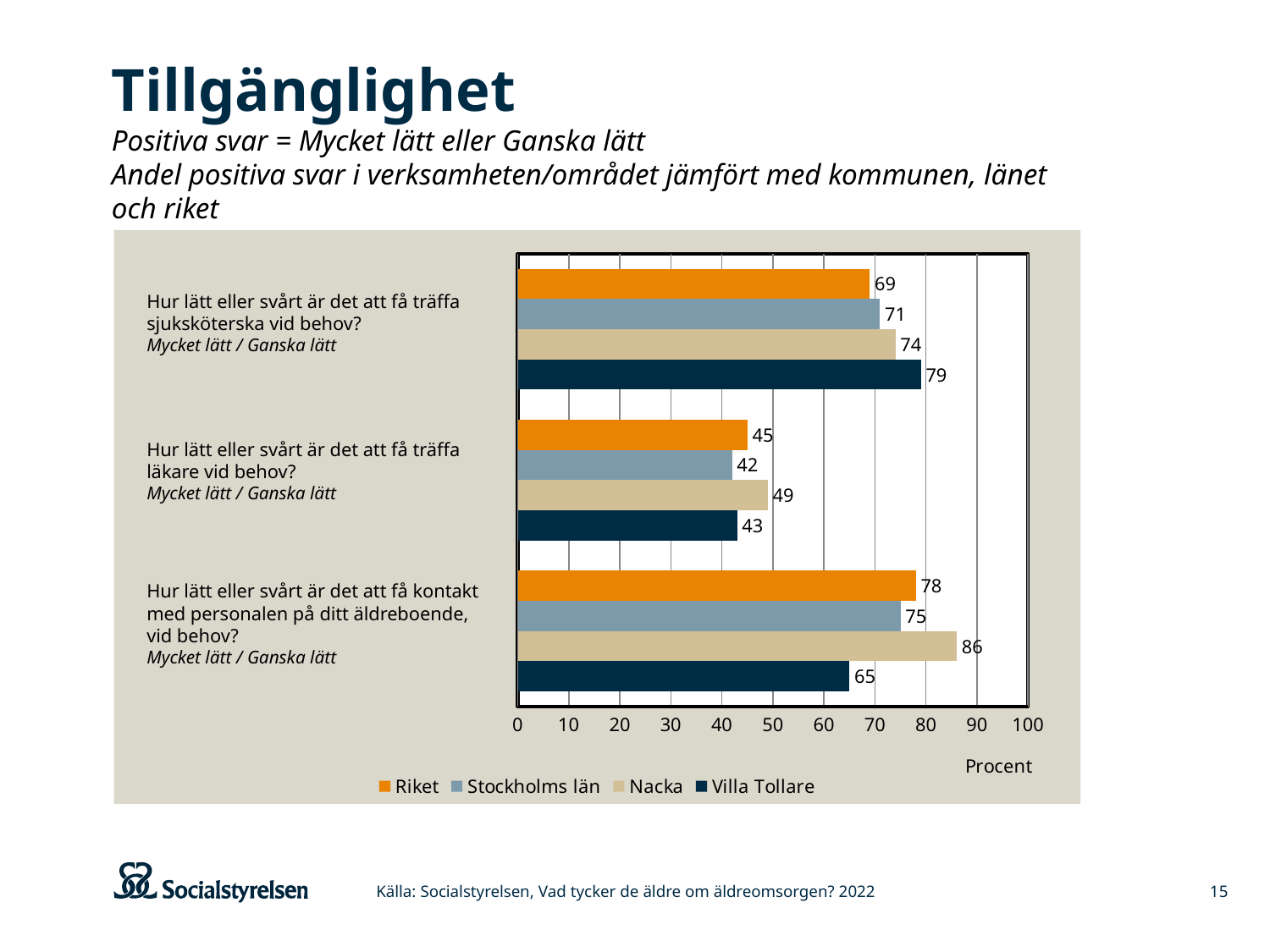
What kind of chart is shown on the slide? Bar chart What value is shown for Nacka on the question about contacting staff at the care home (kontakt med personalen på ditt äldreboende)? 86 What value is shown for Stockholms län on the question about meeting a doctor when needed (träffa läkare vid behov)? 42 How many questions (categories) are shown on the chart? 3 How many series does the legend list? 4 Which series has the highest value on the question about meeting a doctor when needed (träffa läkare vid behov)? Nacka Which colour represents Riket in the legend? Orange What is the unit label shown below the x axis? Procent Which series has the lowest value on the question about contacting staff at the care home (kontakt med personalen)? Villa Tollare What value is shown for Villa Tollare on the question about meeting a nurse when needed (träffa sjuksköterska vid behov)? 79 Which is larger on the question about meeting a nurse (träffa sjuksköterska): Riket or Villa Tollare? Villa Tollare What is the difference between Nacka and Villa Tollare on the question about contacting staff at the care home (kontakt med personalen)? 21